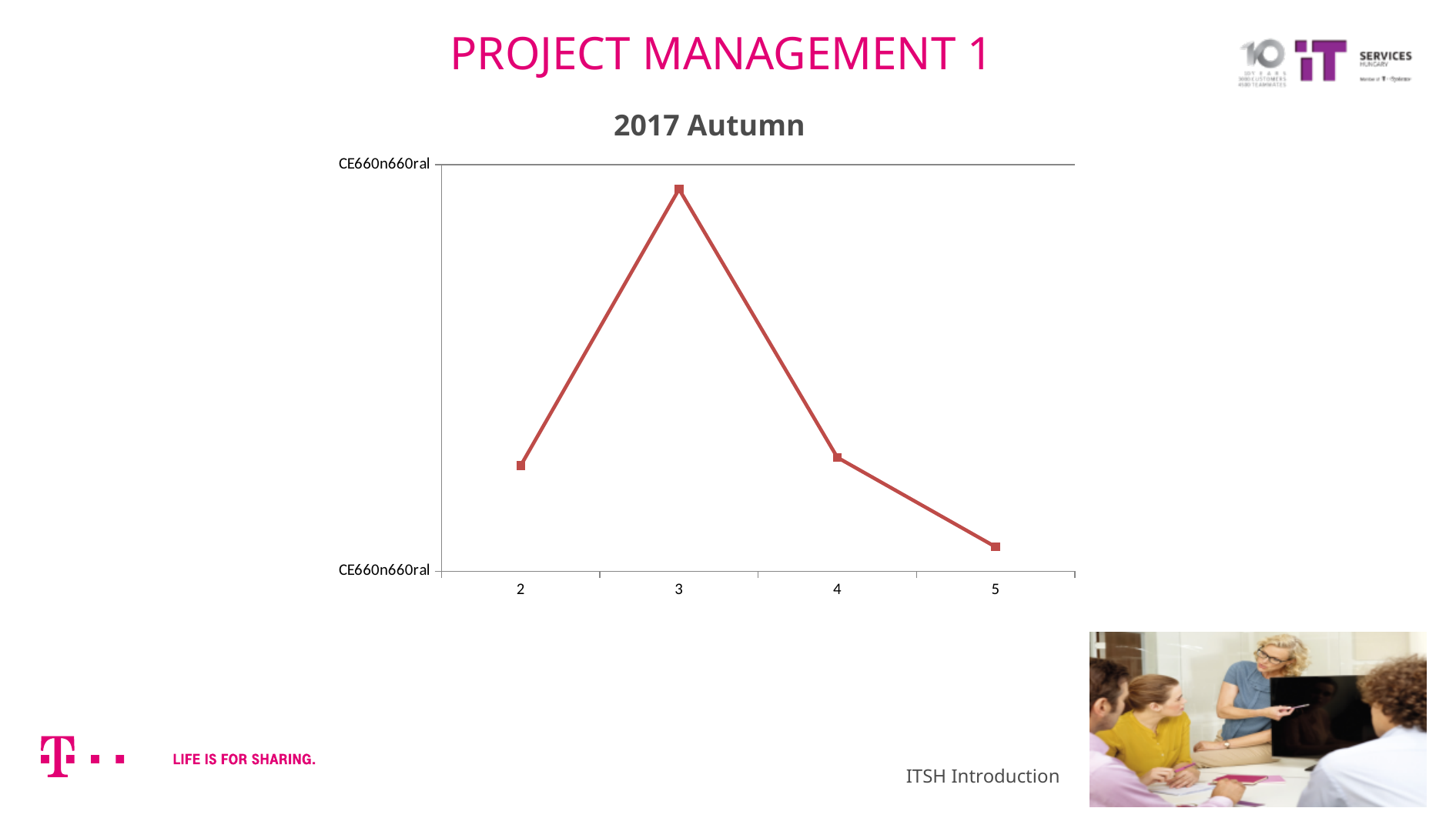
Which has the larger value, category 2 or category 3? 3 What are the category labels shown on the x axis? 2, 3, 4, 5 Does the line rise or fall from category 3 to category 5? fall Which has the larger value, category 4 or category 5? 4 Which x-axis category has the lowest value? 5 What kind of chart is shown on the slide? line chart What is the title of the chart? 2017 Autumn How many data points are plotted on the line? 4 Does the line rise or fall from category 2 to category 3? rise Which x-axis category has the highest value? 3 Which has the larger value, category 2 or category 5? 2